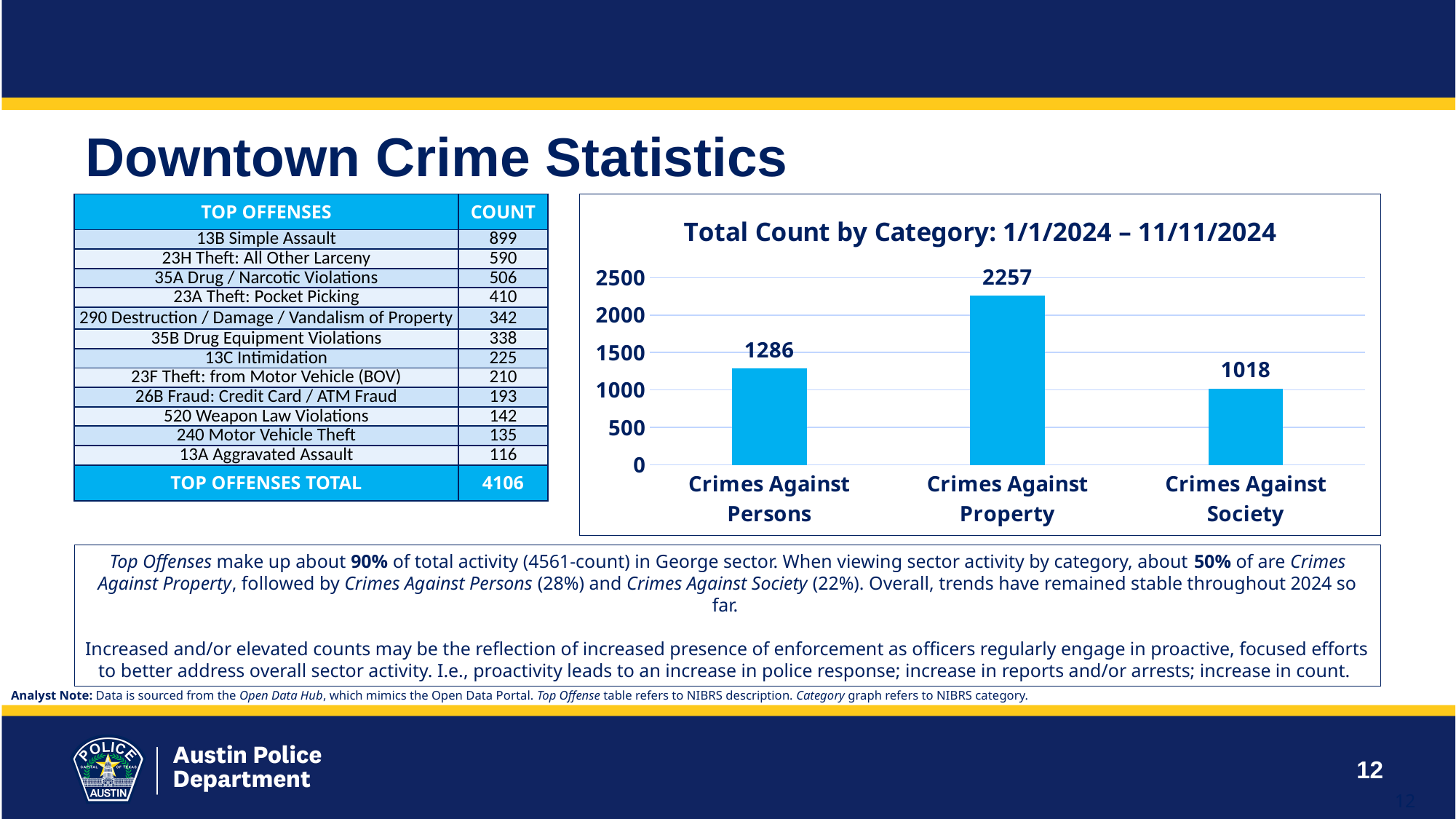
How many categories are shown in the chart? 3 What is the value for Crimes Against Society in the chart? 1018 Is the value for Crimes Against Property greater or less than 2000? greater What is the difference between the counts for Crimes Against Property and Crimes Against Persons? 971 What is the value for Crimes Against Persons in the chart? 1286 What is the difference between the counts for Crimes Against Persons and Crimes Against Society? 268 Which category has the lowest count in the chart? Crimes Against Society What kind of chart is shown on the slide? Bar chart What is the value for Crimes Against Property in the chart? 2257 What is the title of the chart? Total Count by Category: 1/1/2024 – 11/11/2024 Which is larger, the count for Crimes Against Persons or Crimes Against Society? Crimes Against Persons Which category has the highest count in the chart? Crimes Against Property